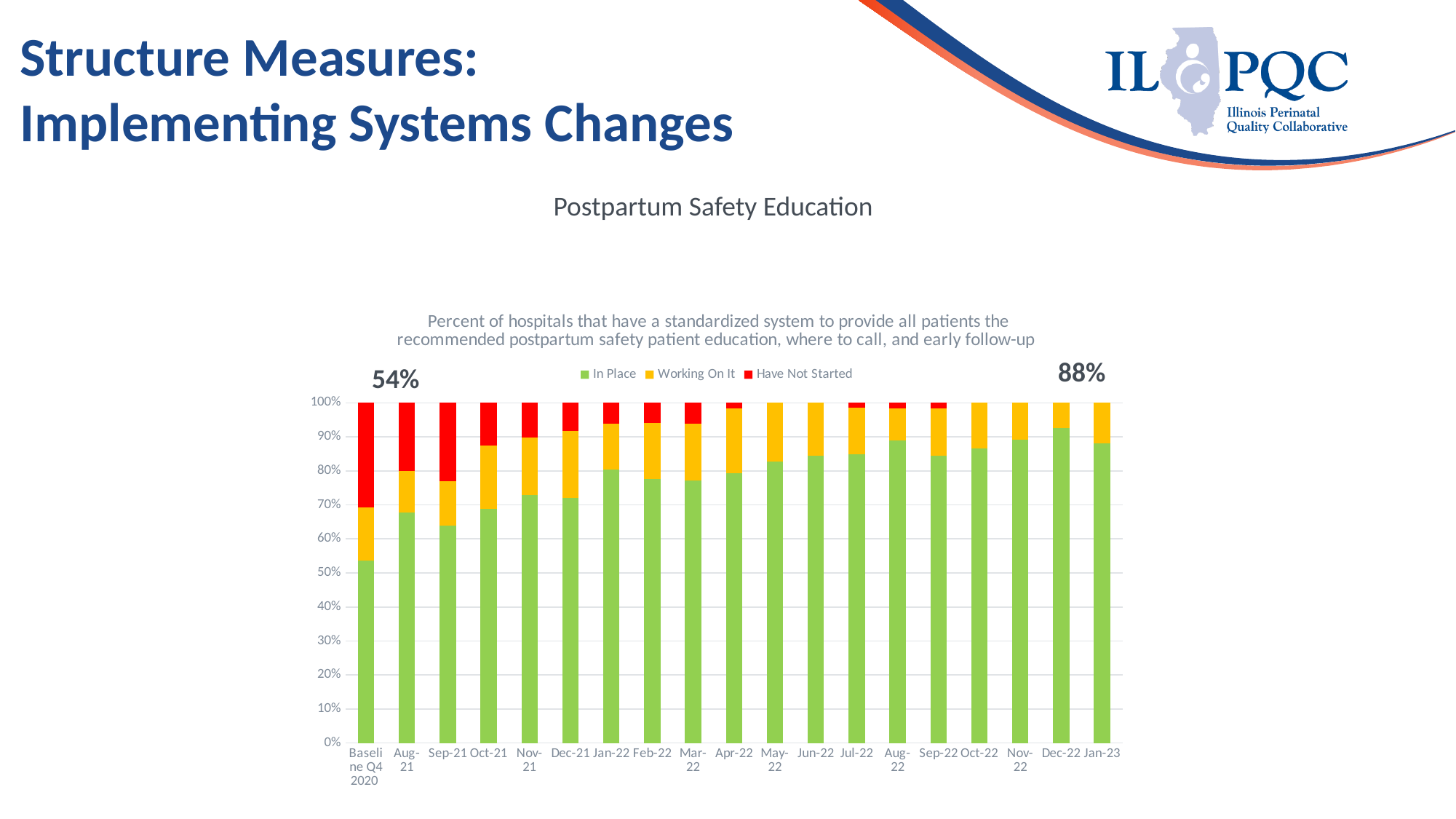
How many series does the legend list? 3 Overall, does the In Place share rise or fall from Baseline Q4 2020 to Jan-23? Rise What type of chart is shown on the slide? Stacked bar chart What percentage of hospitals had the system In Place at Baseline Q4 2020, as labeled on the chart? 54% Is the In Place value for Dec-22 greater or less than 90%? greater Which period has the highest In Place share? Dec-22 Is the In Place value for Sep-21 greater or less than 70%? less Which period has the lowest In Place share? Baseline Q4 2020 How many time periods (bars) are shown on the x axis? 19 What percentage of hospitals had the system In Place in Jan-23, as labeled on the chart? 88% By how many percentage points did the labeled In Place value increase from Baseline Q4 2020 to Jan-23? 34 percentage points Which period has the largest Have Not Started share? Baseline Q4 2020